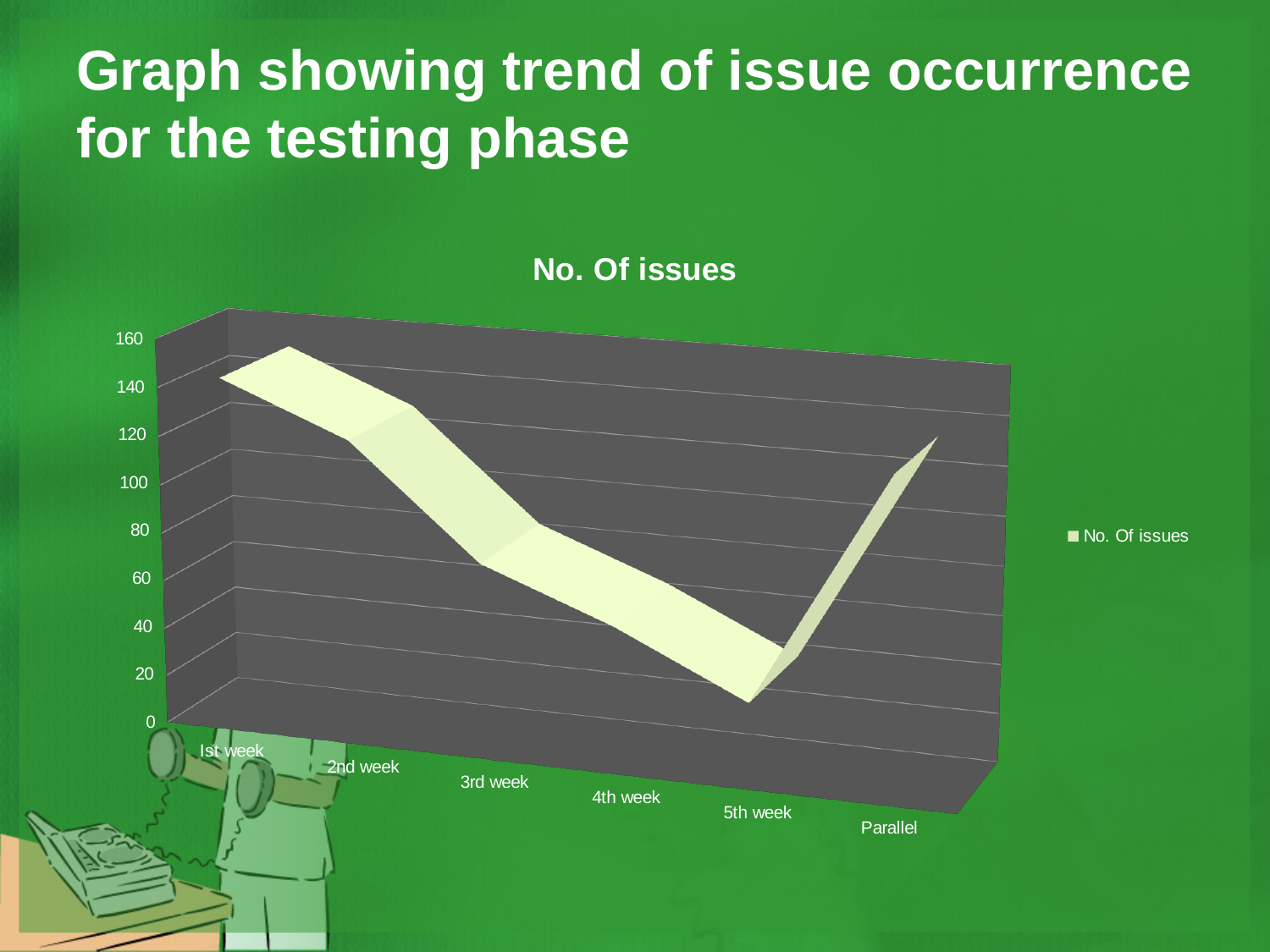
Is the value for Parallel greater or less than 60? greater Is the value for 3rd week greater or less than 100? less Is the value for Ist week greater or less than 120? greater Which category has the lowest number of issues? 5th week Do the values rise or fall from Ist week to 5th week? fall How many categories are shown on the x axis? 6 What is the title of the chart? No. Of issues What kind of chart is shown on the slide? line chart How many series does the legend list? 1 Which has more issues, 2nd week or 4th week? 2nd week Which category has the highest number of issues? Ist week